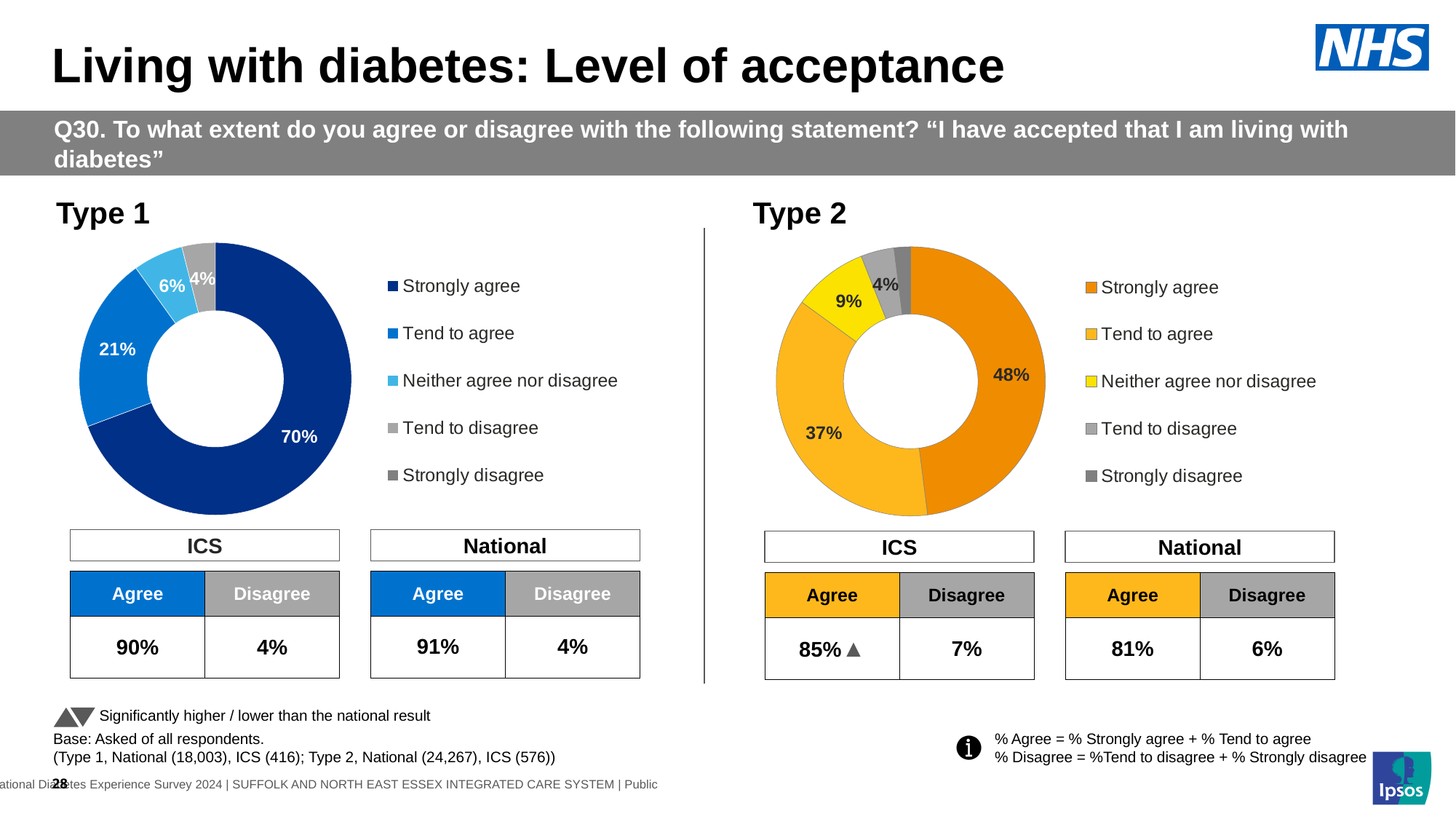
What kind of chart is used for Type 2? Donut (pie) chart In the Type 2 chart, which response category has the largest share? Strongly agree How many response categories does the legend of the Type 1 chart list? 5 In the Type 1 chart, what is the difference between the Strongly agree and Tend to agree shares? 49 percentage points In the Type 2 chart, what is the difference between the Strongly agree and Tend to agree shares? 11 percentage points In the Type 2 chart, what percentage of respondents neither agree nor disagree? 9% In the Type 1 chart, what percentage of respondents tend to agree? 21% In the Type 2 chart, what percentage of respondents tend to agree? 37% Which chart has a larger Strongly agree share, Type 1 or Type 2? Type 1 In the Type 1 chart, what percentage of respondents strongly agree? 70% In the Type 2 chart, what percentage of respondents strongly agree? 48% In the Type 1 chart, which response category has the largest share? Strongly agree